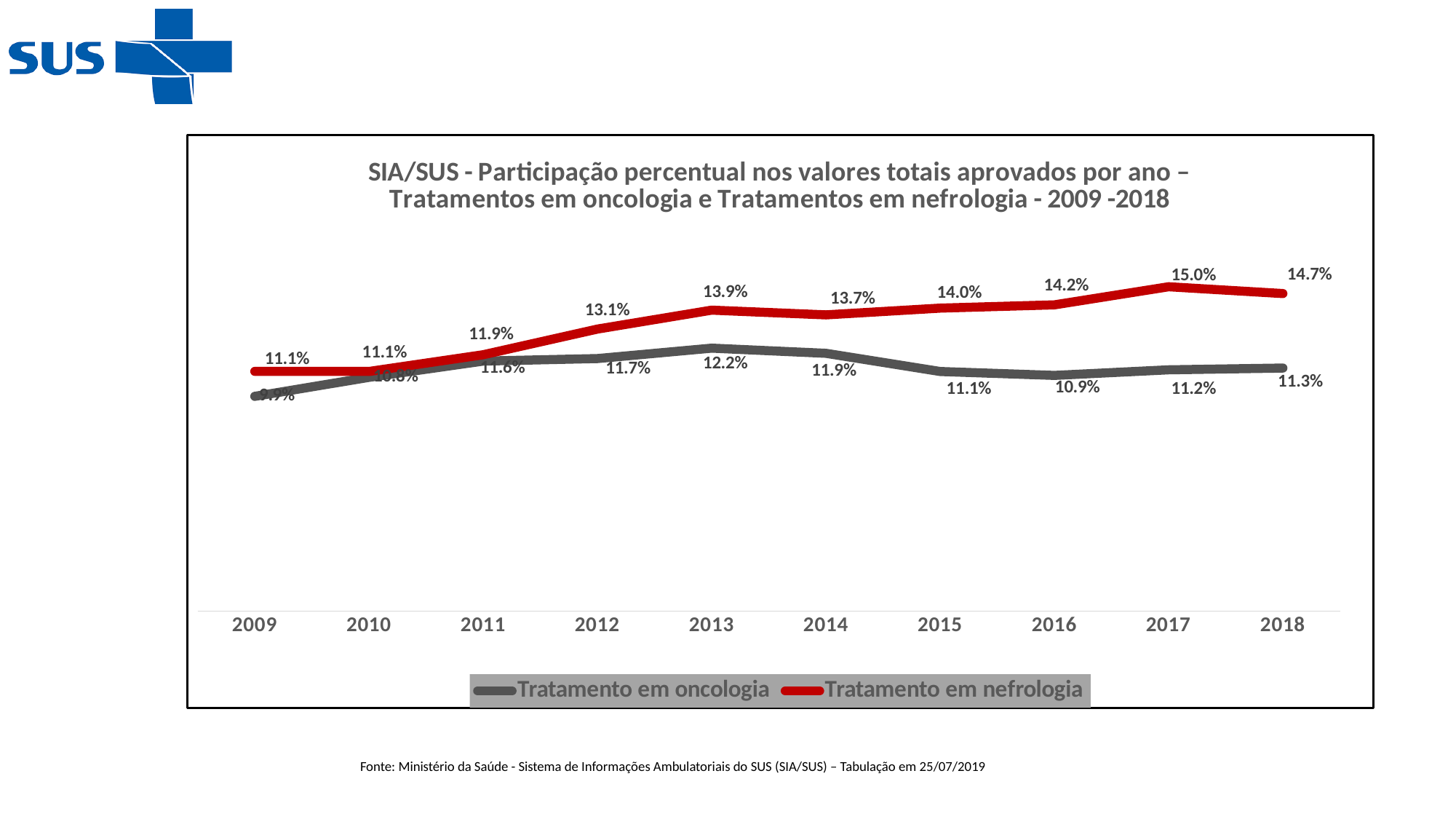
In which year is Tratamento em oncologia highest? 2013 What is the difference between Tratamento em nefrologia and Tratamento em oncologia in 2018? 3.4% How many years are shown on the x axis? 10 What type of chart is shown on the slide? line chart What colour is the line for Tratamento em nefrologia? red In which year is Tratamento em nefrologia highest? 2017 How many series does the legend list? 2 What is the value for Tratamento em nefrologia in 2012? 13.1% What is the value for Tratamento em oncologia in 2013? 12.2% What is the value for Tratamento em oncologia in 2016? 10.9% Which series has the larger value in 2015, Tratamento em oncologia or Tratamento em nefrologia? Tratamento em nefrologia What is the value for Tratamento em nefrologia in 2017? 15.0%